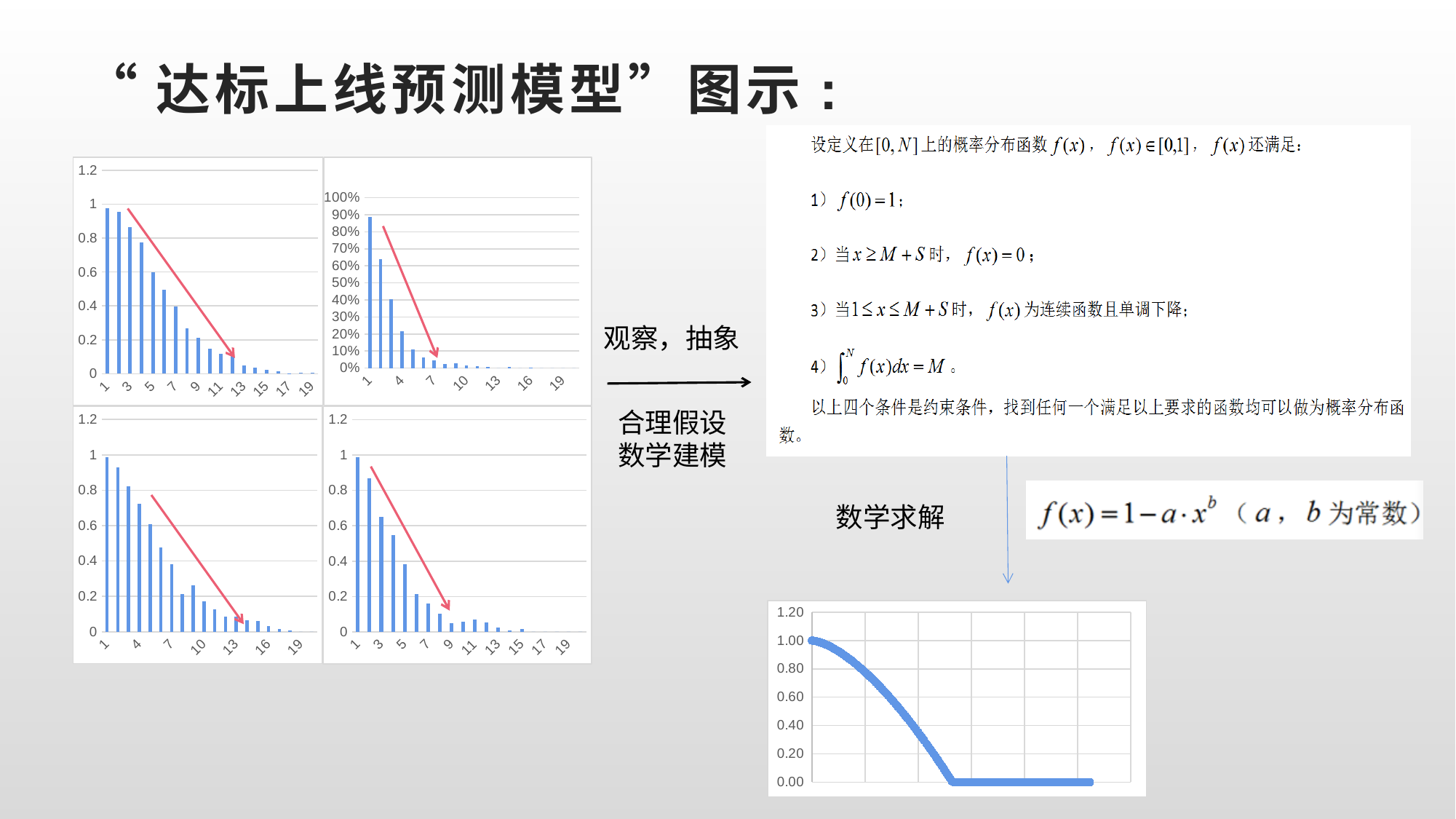
In the top-left bar chart, do the values rise or fall as the category number increases along the x axis? fall In the top-right bar chart, is the value for category 1 greater or less than 80%? greater In the bottom-left bar chart, which is larger, the value for category 1 or the value for category 13? category 1 In the bottom-right bar chart, is the value for category 9 greater or less than 0.2? less Which of the four bar charts on the left uses a percentage scale on its y axis? the top-right chart In the top-right bar chart, is the value for category 7 greater or less than 20%? less In the chart at the bottom right of the slide (the one with the y axis from 0.00 to 1.20), do the plotted values rise or fall as x increases? fall In the top-left bar chart, which category has the highest value? 1 What kind of chart is the top-left chart on the slide? bar chart In the bottom-right bar chart, which category has the highest value? 1